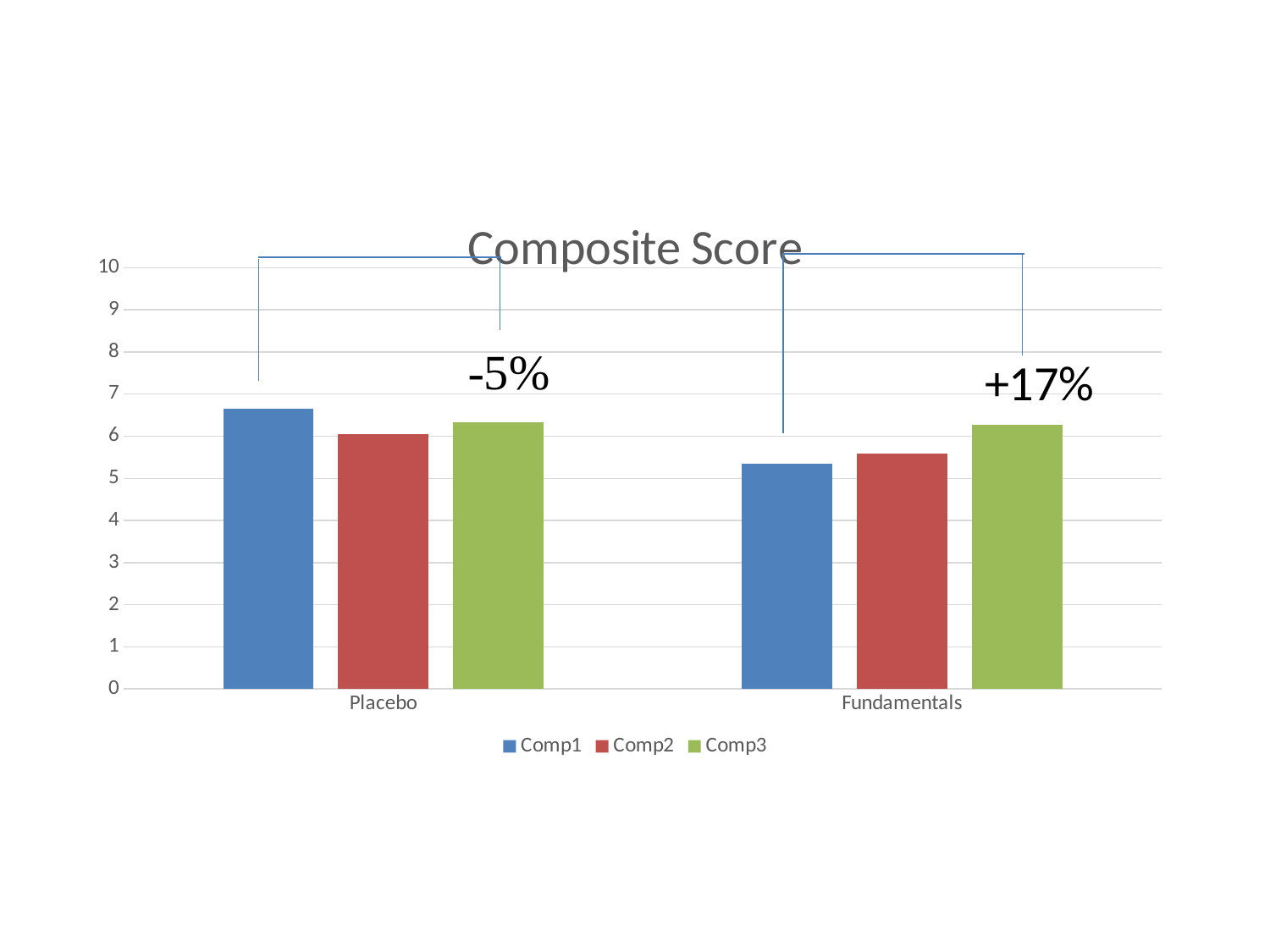
Is the Comp2 value for Fundamentals greater or less than 6? less Which series has the highest value in the Fundamentals category? Comp3 Is the Comp3 value for Fundamentals greater or less than 6? greater Which series has the lowest value in the Fundamentals category? Comp1 What is the title of the chart? Composite Score What percentage annotation is shown above the Fundamentals bars? +17% What type of chart is shown on the slide? bar chart Is the Comp1 value for Fundamentals greater or less than 6? less Which is larger, the Comp1 value for Placebo or the Comp1 value for Fundamentals? Placebo How many categories are shown on the x axis? 2 How many series does the legend list? 3